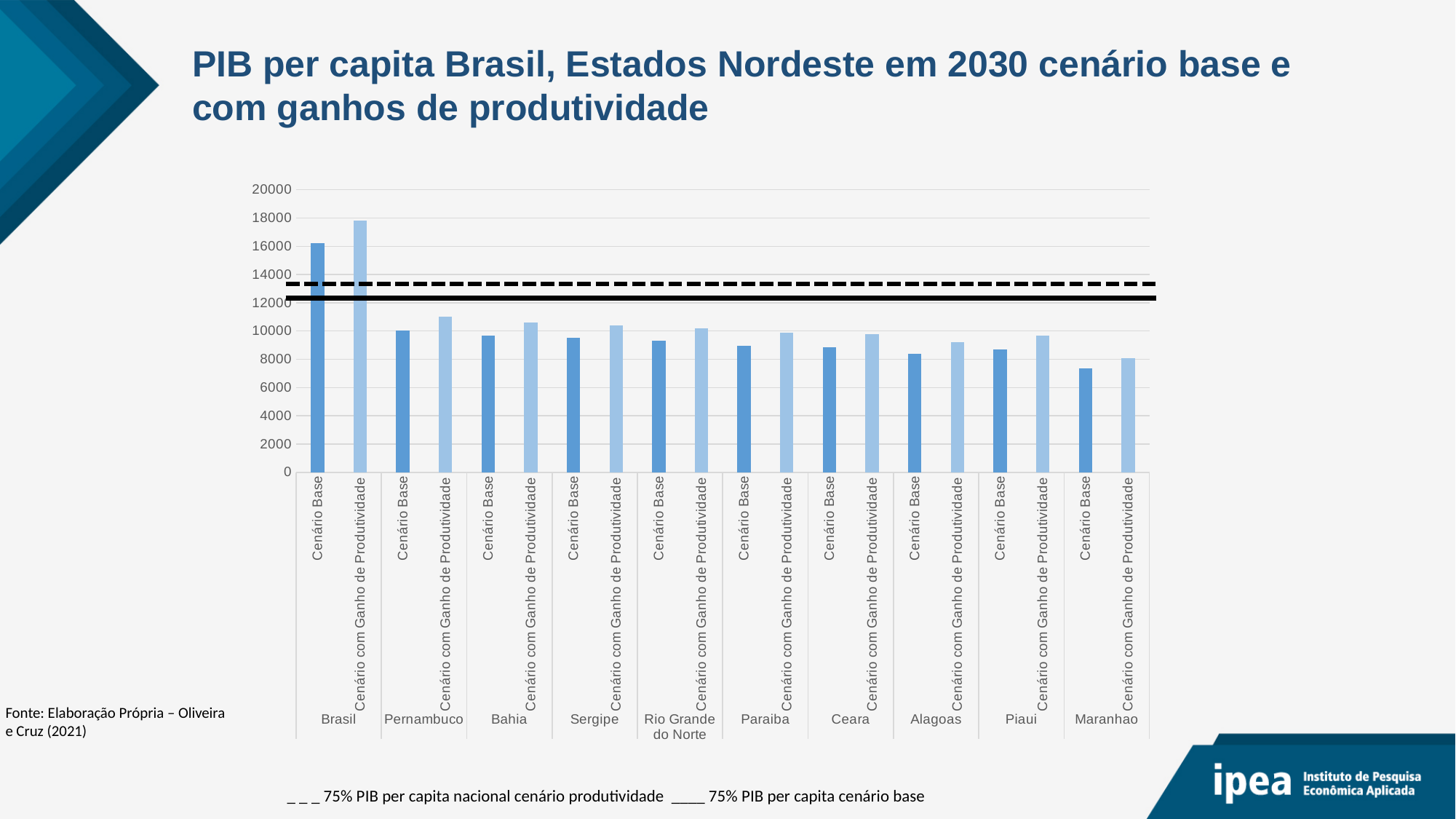
According to the legend below the chart, what does the dashed horizontal line represent? 75% PIB per capita nacional cenário produtividade Which bar is the lowest in the chart? Maranhao, Cenário Base Which is larger: Brasil Cenário Base or Pernambuco Cenário com Ganho de Produtividade? Brasil Cenário Base Is the value for Alagoas Cenário Base greater or less than 10000? less Is the value for Maranhao Cenário Base greater or less than 8000? less Is the value for Pernambuco Cenário com Ganho de Produtividade greater or less than 10000? greater Which is larger: Pernambuco Cenário Base or Maranhao Cenário Base? Pernambuco Cenário Base Do the Cenário Base values for the states generally rise or fall from Pernambuco to Maranhao along the x axis? fall How many regions (Brasil plus states) are shown along the x axis of the chart? 10 What kind of chart is shown on the slide? bar chart Which bar is the highest in the chart? Brasil, Cenário com Ganho de Produtividade